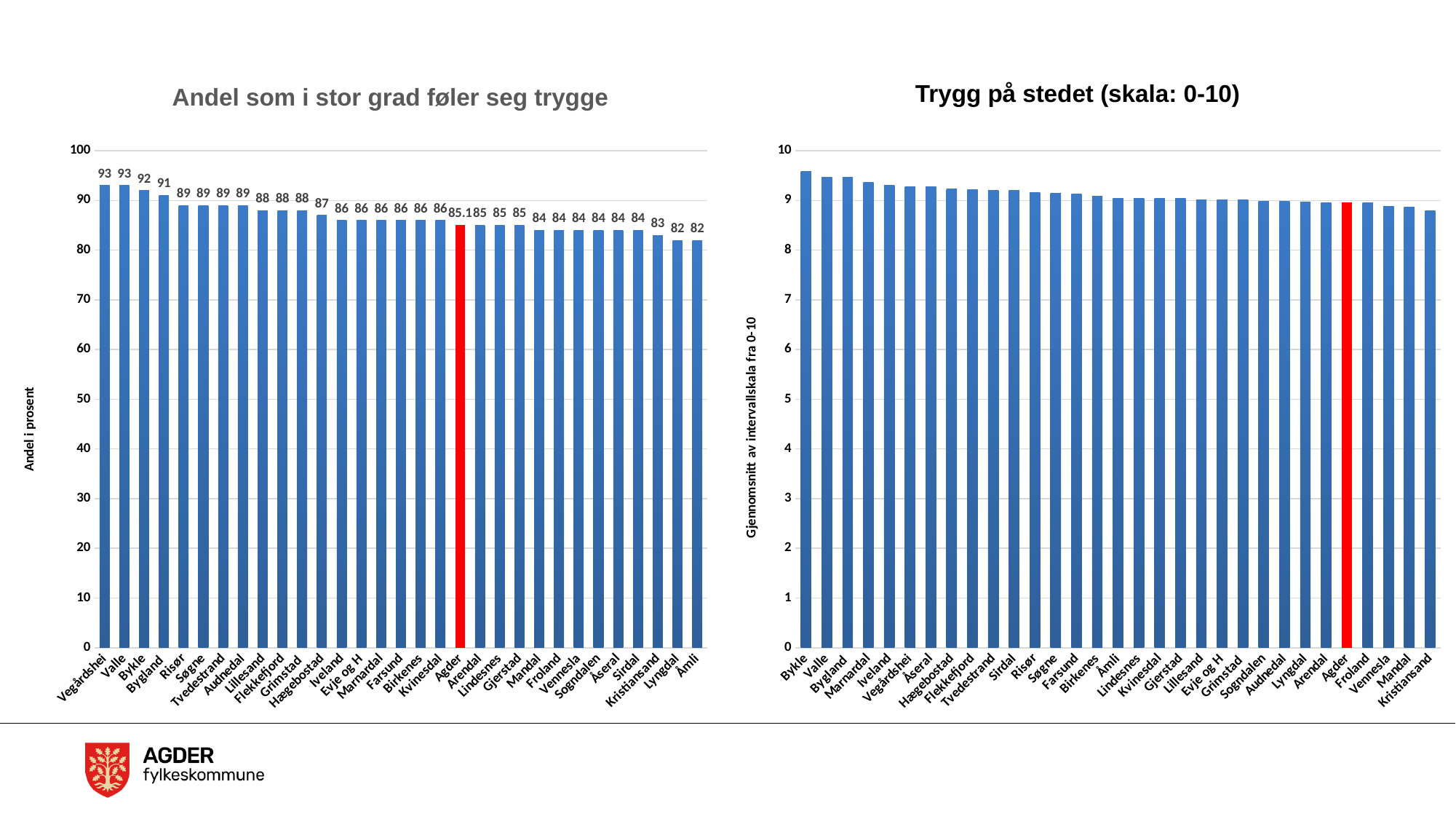
In the chart 'Trygg på stedet (skala: 0-10)', is the value for Kristiansand greater or less than 9? less In the chart 'Andel som i stor grad føler seg trygge', which has the larger value, Bykle or Lyngdal? Bykle How many categories are shown in the chart 'Andel som i stor grad føler seg trygge'? 31 In the chart 'Andel som i stor grad føler seg trygge', what is the lowest value shown? 82 What kind of chart is 'Trygg på stedet (skala: 0-10)'? Bar chart In the chart 'Andel som i stor grad føler seg trygge', which category is shown with a red bar? Agder In the chart 'Andel som i stor grad føler seg trygge', what is the value for Kristiansand? 83 In the chart 'Andel som i stor grad føler seg trygge', what is the difference between the values for Vegårdshei and Åmli? 11 In the chart 'Trygg på stedet (skala: 0-10)', is the value for Bykle greater or less than 9? greater In the chart 'Andel som i stor grad føler seg trygge', what is the value for Agder? 85.1 In the chart 'Andel som i stor grad føler seg trygge', what is the value for Hægebostad? 87 In the chart 'Trygg på stedet (skala: 0-10)', do the values rise or fall from left to right along the x axis? fall